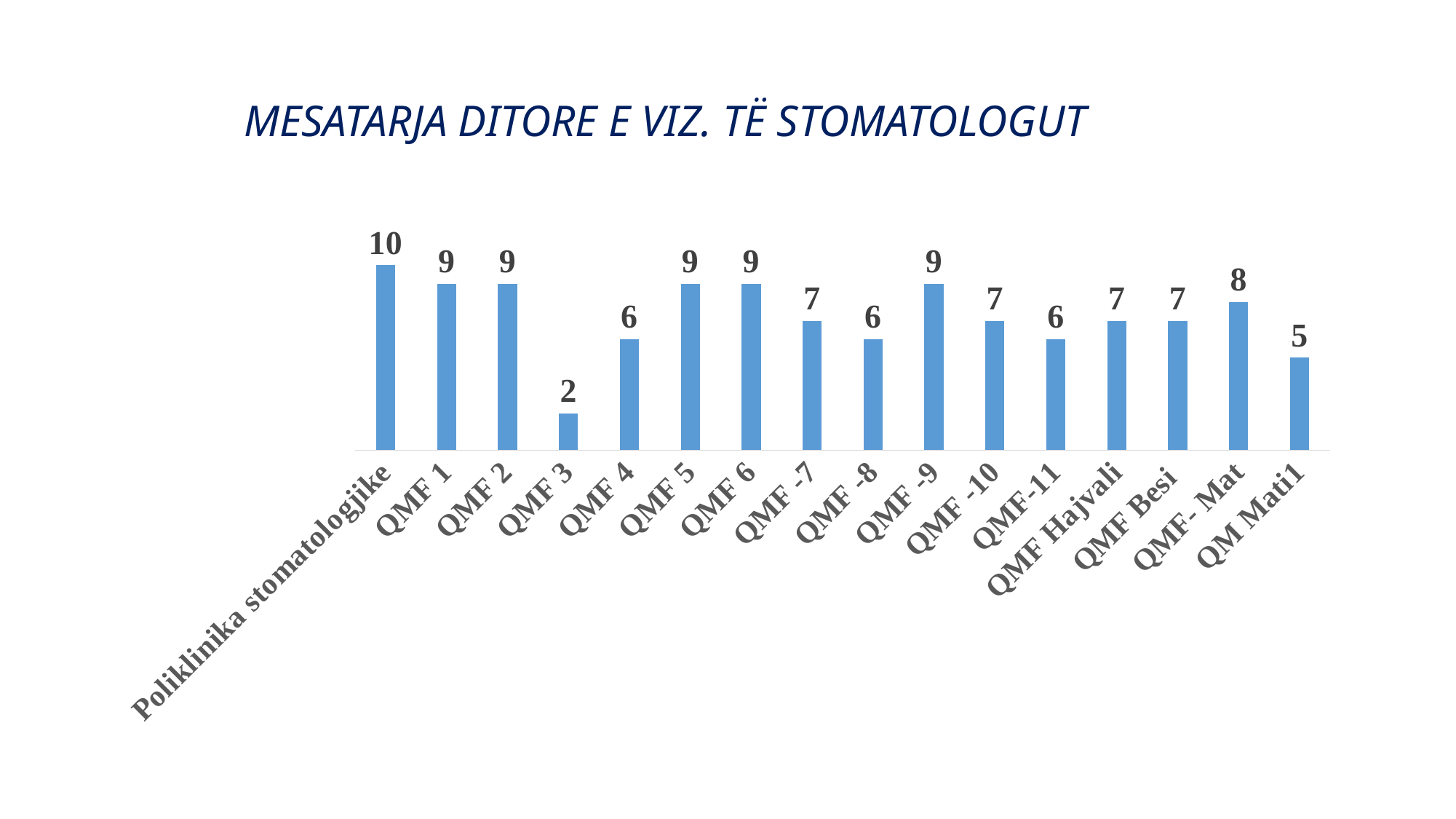
Which category has the lowest value? QMF 3 Which category has the highest value? Poliklinika stomatologjike Which is larger, the value for QMF 4 or the value for QMF 5? QMF 5 What is the value for QMF- Mat? 8 What is the title of the chart? MESATARJA DITORE E VIZ. TË STOMATOLOGUT What is the value for QMF 3? 2 What is the value for Poliklinika stomatologjike? 10 What is the value for QM Mati1? 5 What is the difference between the values for QMF- Mat and QM Mati1? 3 What kind of chart is shown on the slide? Bar chart What is the difference between the values for Poliklinika stomatologjike and QMF 3? 8 How many categories are shown on the x axis? 16